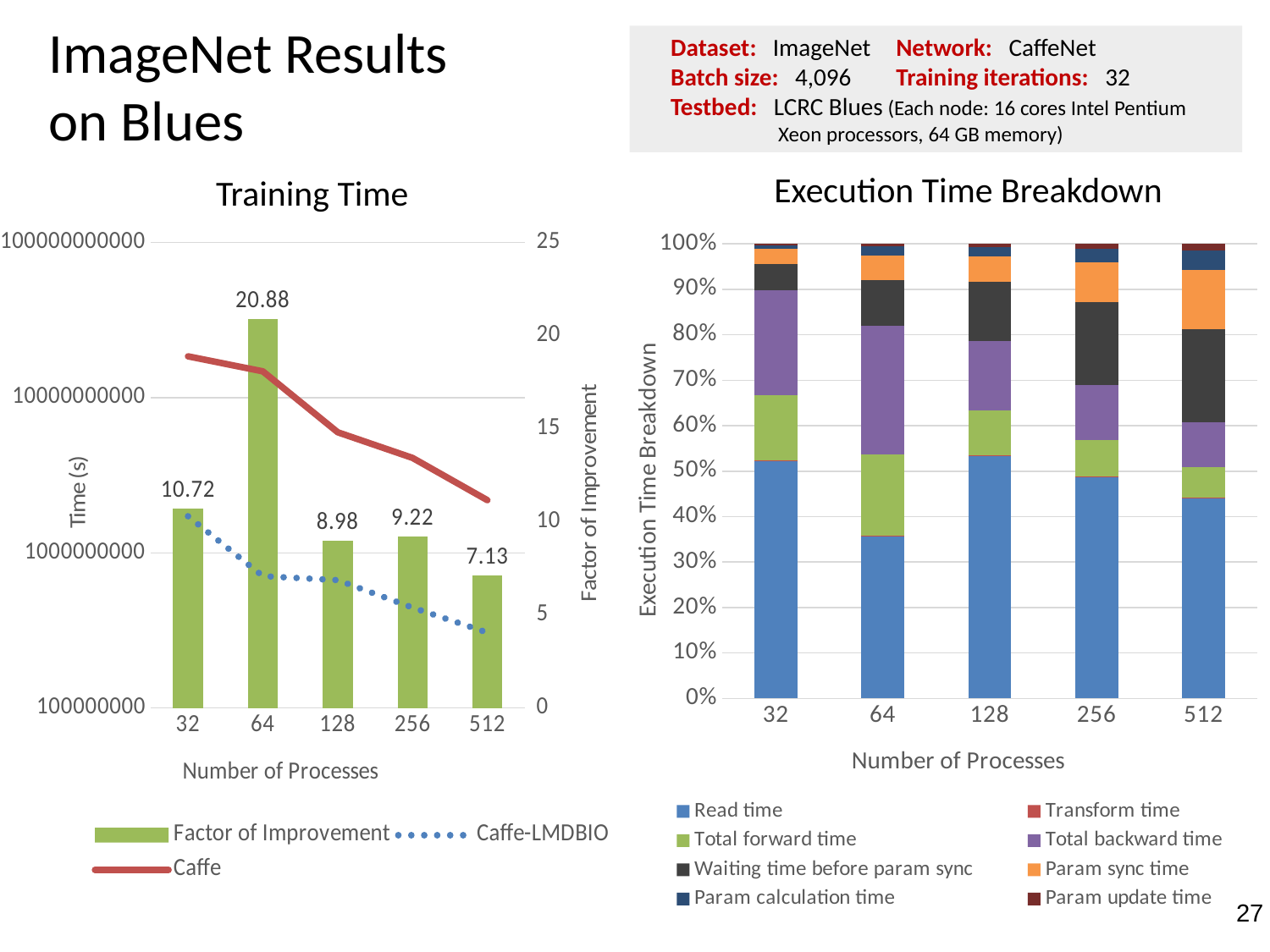
What kind of chart is the Execution Time Breakdown chart? Stacked bar chart In the Training Time chart, what is the Factor of Improvement at 64 processes? 20.88 In the Training Time chart, does the Caffe line rise or fall as the number of processes increases? Fall In the Execution Time Breakdown chart, how many series does the legend list? 8 In the Training Time chart, which number of processes has the lowest Factor of Improvement? 512 In the Training Time chart, how many series does the legend list? 3 In the Training Time chart, what is the difference between the Factor of Improvement at 64 processes and at 32 processes? 10.16 In the Execution Time Breakdown chart, how many numbers of processes are shown on the x axis? 5 In the Training Time chart, what is the Factor of Improvement at 512 processes? 7.13 In the Training Time chart, which number of processes has the highest Factor of Improvement? 64 In the Training Time chart, is the Factor of Improvement larger at 128 or at 256 processes? 256 In the Execution Time Breakdown chart, is the Read time share at 64 processes greater or less than 40%? less